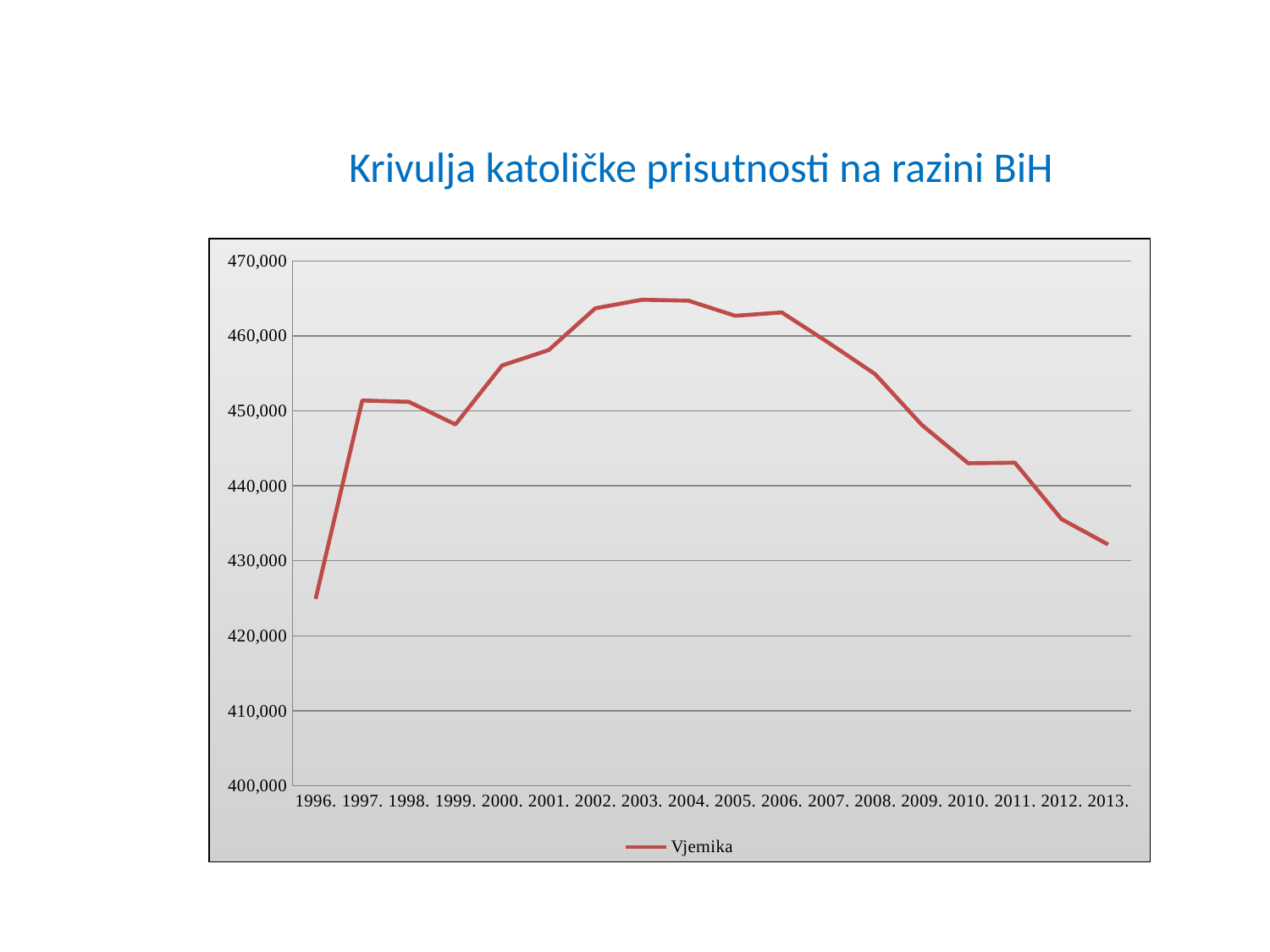
Is the value for 1996. greater or less than 430,000? less Is the value for 2000. greater or less than 450,000? greater What is the title of the chart? Krivulja katoličke prisutnosti na razini BiH Which year has the lowest value? 1996. How many years are plotted along the x axis? 18 What kind of chart is shown on the slide? line chart Is the value for 2003. greater or less than 460,000? greater Do the values rise or fall from 2006. to 2013.? fall How many series does the legend list? 1 What is the name of the series shown in the legend? Vjernika Which is larger, the value for 2006. or the value for 2010.? 2006.